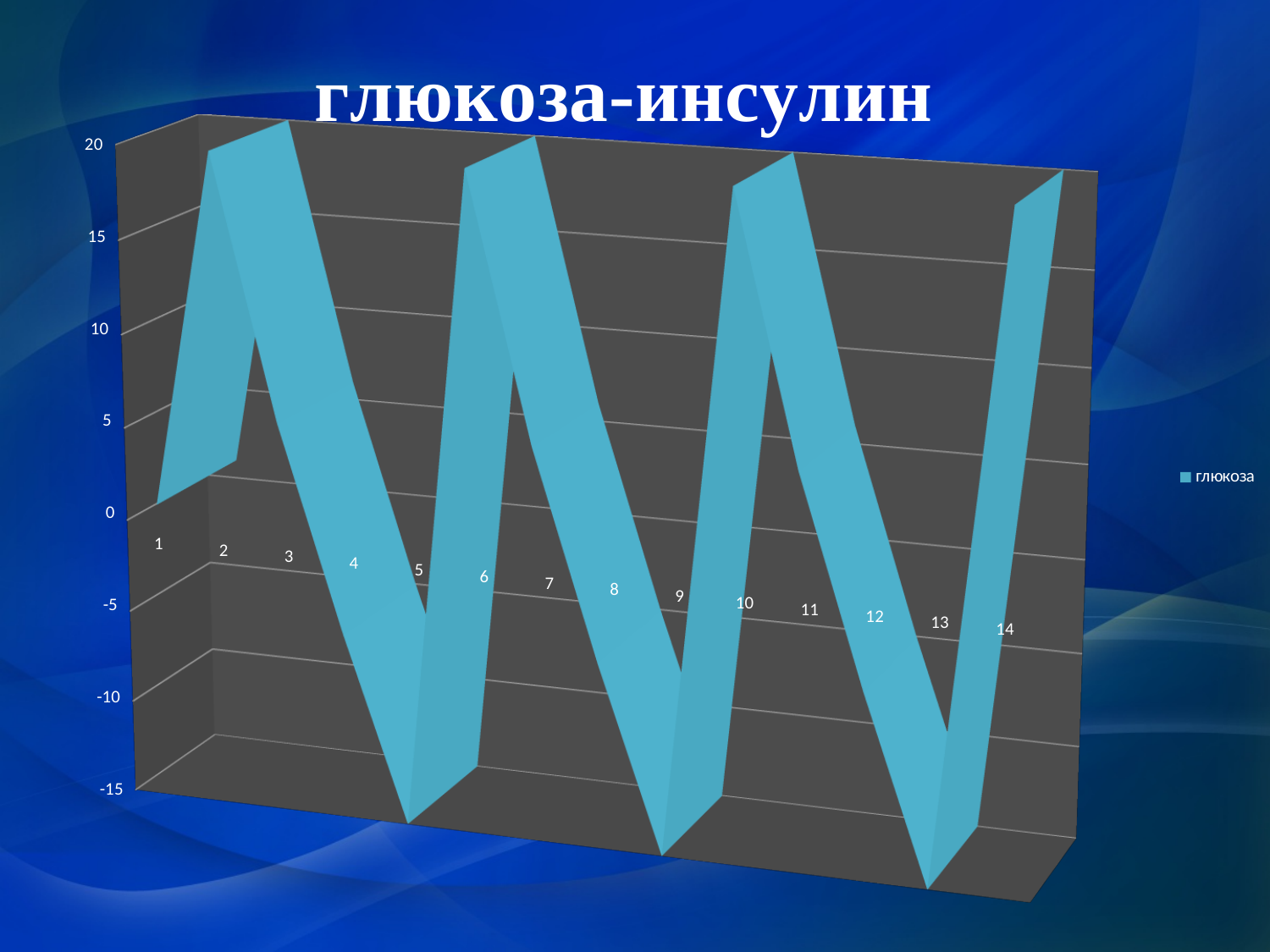
What is the title of the chart? глюкоза-инсулин Is the value for category 5 greater or less than -5? less Is the value for category 2 greater or less than 10? greater What is the name of the series shown in the legend? глюкоза How many categories are shown on the x axis? 14 Do the values rise or fall from category 2 to category 5? fall Is the value for category 8 greater or less than 10? less How many series does the legend list? 1 Which is larger, the value for category 2 or the value for category 5? category 2 What kind of chart is shown on the slide? line chart